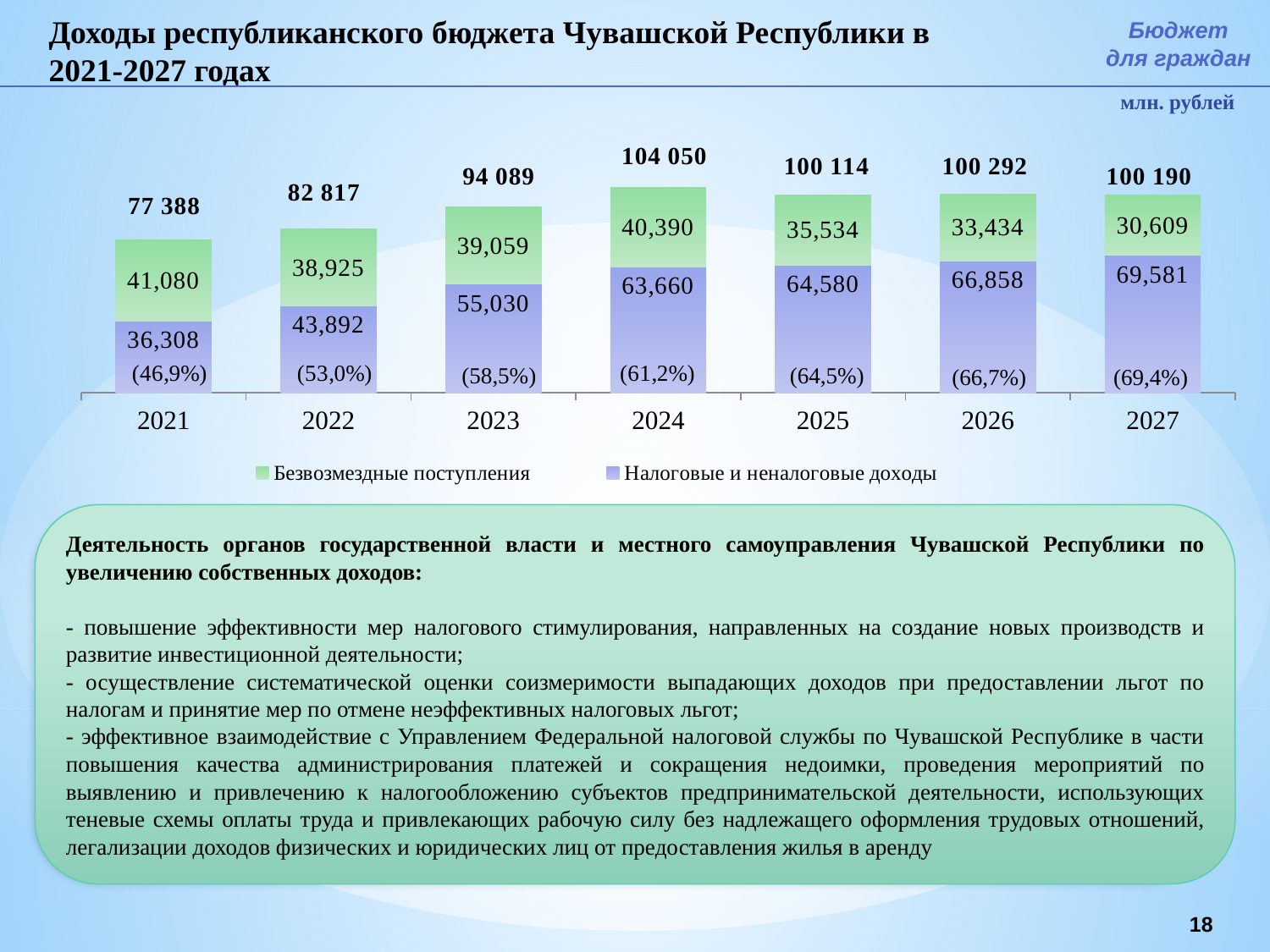
What is the total revenue shown above the bar for 2023? 94 089 Which year has the lowest total revenue? 2021 Do the values of Налоговые и неналоговые доходы rise or fall from 2021 to 2027? rise Which is larger in 2022: Безвозмездные поступления or Налоговые и неналоговые доходы? Налоговые и неналоговые доходы What percentage is shown in parentheses for 2026? (66,7%) What is the value of Налоговые и неналоговые доходы for 2024? 63,660 Which year has the lowest value of Безвозмездные поступления? 2027 How many series does the chart legend list? 2 What is the value of Безвозмездные поступления for 2021? 41,080 What is the difference between Налоговые и неналоговые доходы and Безвозмездные поступления in 2027? 38,972 How many years are shown on the x axis of the chart? 7 Which year has the highest total revenue? 2024